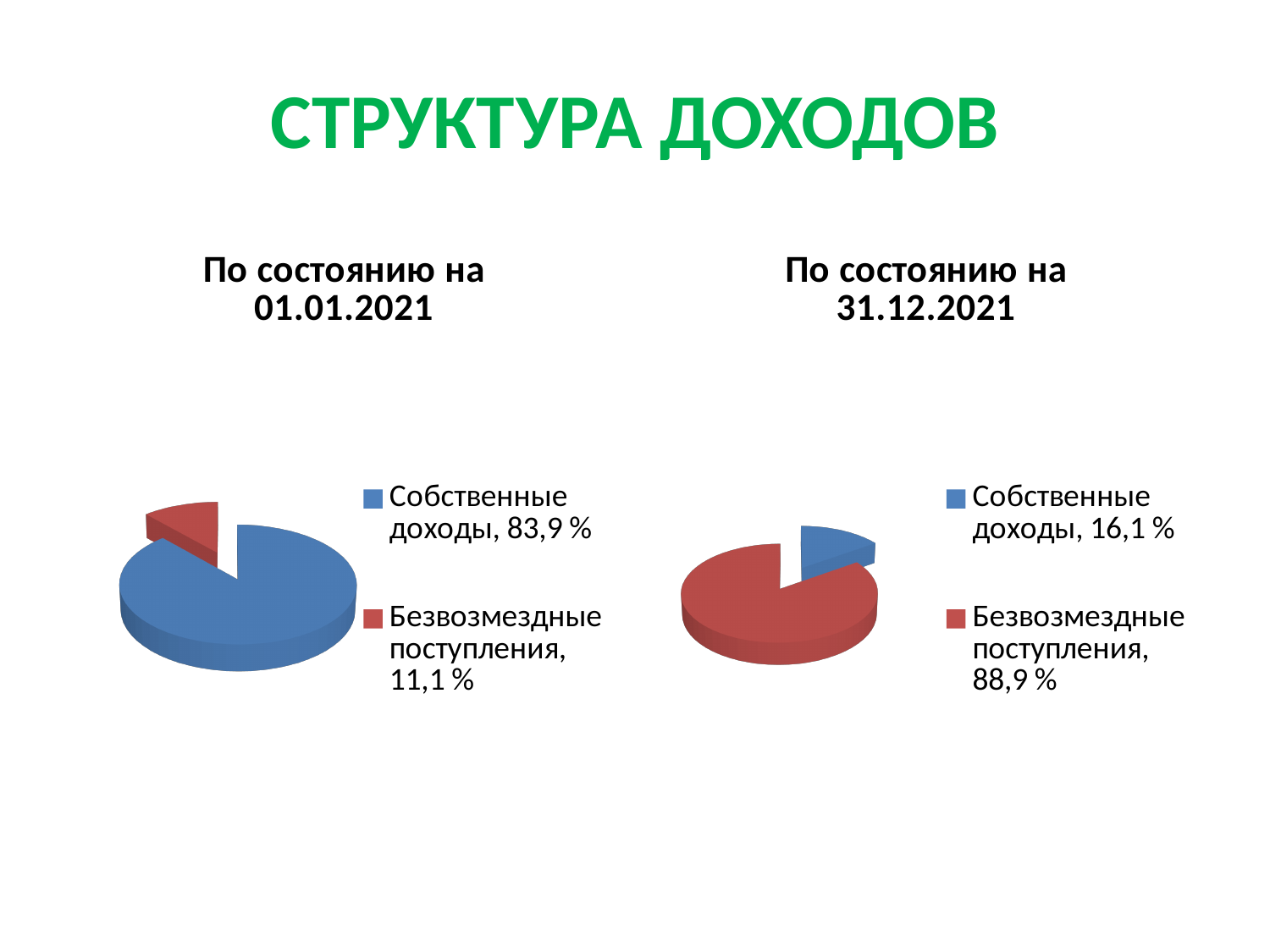
On the pie chart titled "По состоянию на 31.12.2021", what is the difference between the shares of Безвозмездные поступления and Собственные доходы? 72,8 % On the pie chart titled "По состоянию на 01.01.2021", what share is shown for Собственные доходы? 83,9 % On the pie chart titled "По состоянию на 31.12.2021", what share is shown for Безвозмездные поступления? 88,9 % On the pie chart titled "По состоянию на 01.01.2021", what share is shown for Безвозмездные поступления? 11,1 % On the pie chart titled "По состоянию на 01.01.2021", what colour is the slice for Безвозмездные поступления? Red How many categories does the pie chart titled "По состоянию на 01.01.2021" show? 2 What type of chart is used for "По состоянию на 31.12.2021"? Pie chart On the pie chart titled "По состоянию на 31.12.2021", which is larger: Собственные доходы or Безвозмездные поступления? Безвозмездные поступления On the pie chart titled "По состоянию на 31.12.2021", which category has the smallest slice? Собственные доходы On the pie chart titled "По состоянию на 01.01.2021", which category has the largest slice? Собственные доходы On the pie chart titled "По состоянию на 01.01.2021", what is the difference between the shares of Собственные доходы and Безвозмездные поступления? 72,8 %